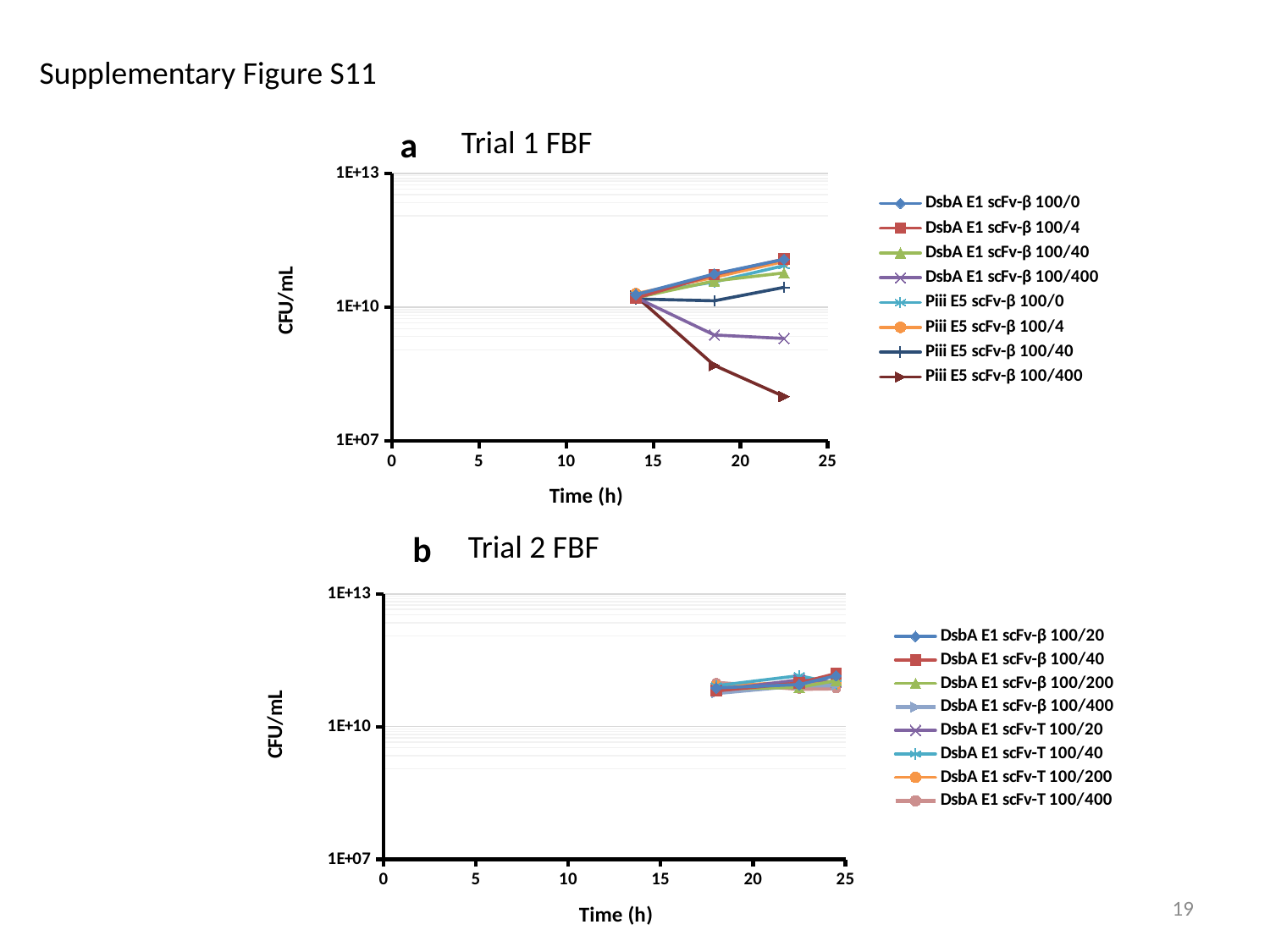
In the Trial 1 FBF chart, is the final value of the DsbA E1 scFv-β 100/400 series greater or less than 1E+10? less What kind of chart is the Trial 1 FBF chart? line chart In the Trial 1 FBF chart, which is larger at the final time point: DsbA E1 scFv-β 100/4 or Piii E5 scFv-β 100/400? DsbA E1 scFv-β 100/4 How many series does the legend of the Trial 2 FBF chart list? 8 In the Trial 1 FBF chart, is the final value of the Piii E5 scFv-β 100/40 series greater or less than 1E+10? greater In the Trial 1 FBF chart, which series has the lowest value at the final time point? Piii E5 scFv-β 100/400 In the Trial 1 FBF chart, does the Piii E5 scFv-β 100/400 series rise or fall over time? fall How many time points are plotted for each series in the Trial 2 FBF chart? 3 In the Trial 2 FBF chart, is the final value of the DsbA E1 scFv-β 100/40 series greater or less than 1E+10? greater In the Trial 1 FBF chart, does the DsbA E1 scFv-β 100/4 series rise or fall over time? rise What is the y-axis label of the Trial 1 FBF chart? CFU/mL How many series does the legend of the Trial 1 FBF chart list? 8